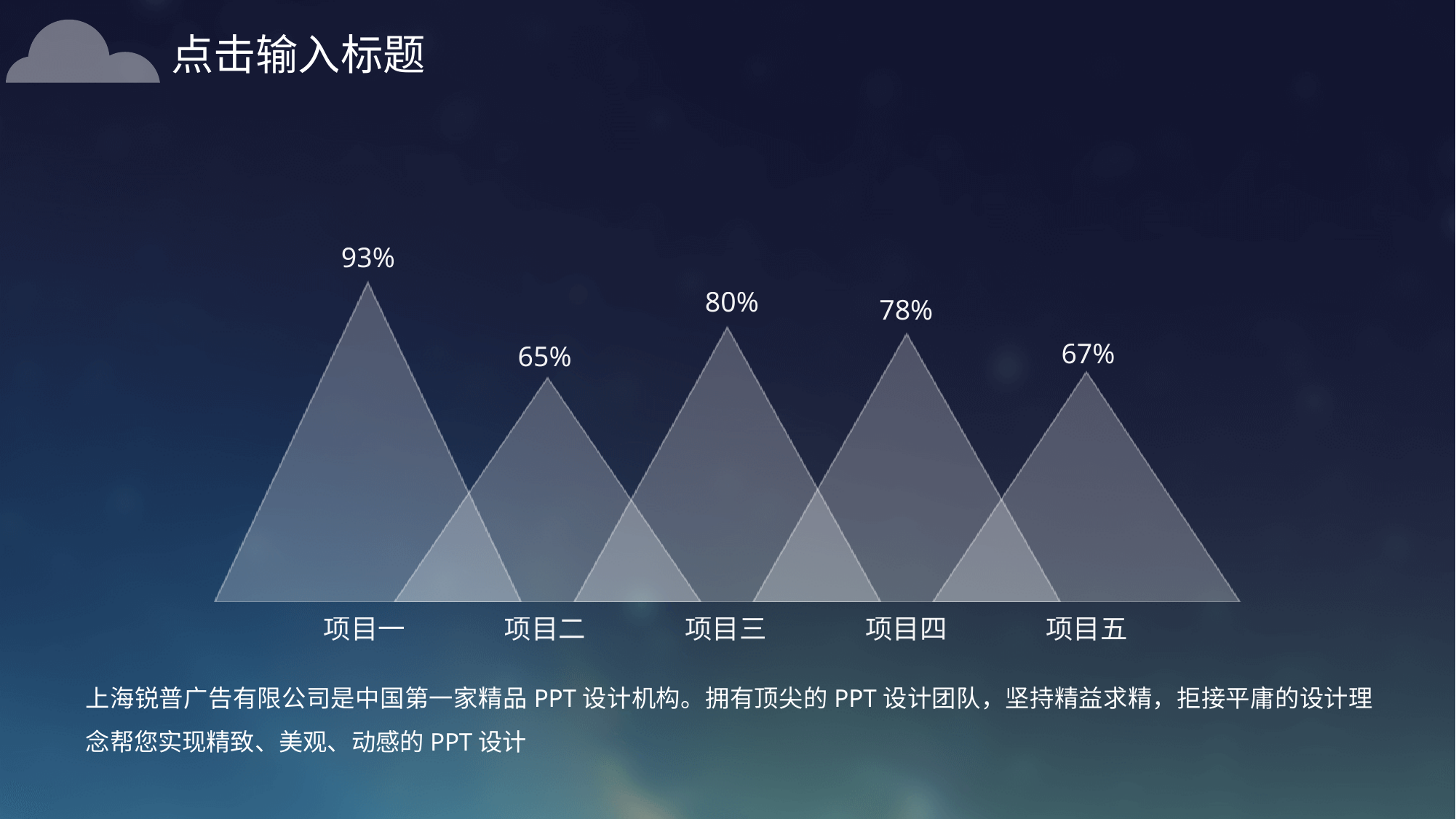
What is the value for 项目二? 65% What is the title shown at the top of the slide? 点击输入标题 What is the value for 项目四? 78% How many categories are shown in the chart? 5 Which category has the lowest value? 项目二 Which is larger, the value for 项目三 or the value for 项目四? 项目三 Which category has the highest value? 项目一 What is the value for 项目五? 67% What is the difference between the values for 项目一 and 项目二? 28% What is the value for 项目三? 80% What is the difference between the values for 项目三 and 项目五? 13% What is the value for 项目一? 93%